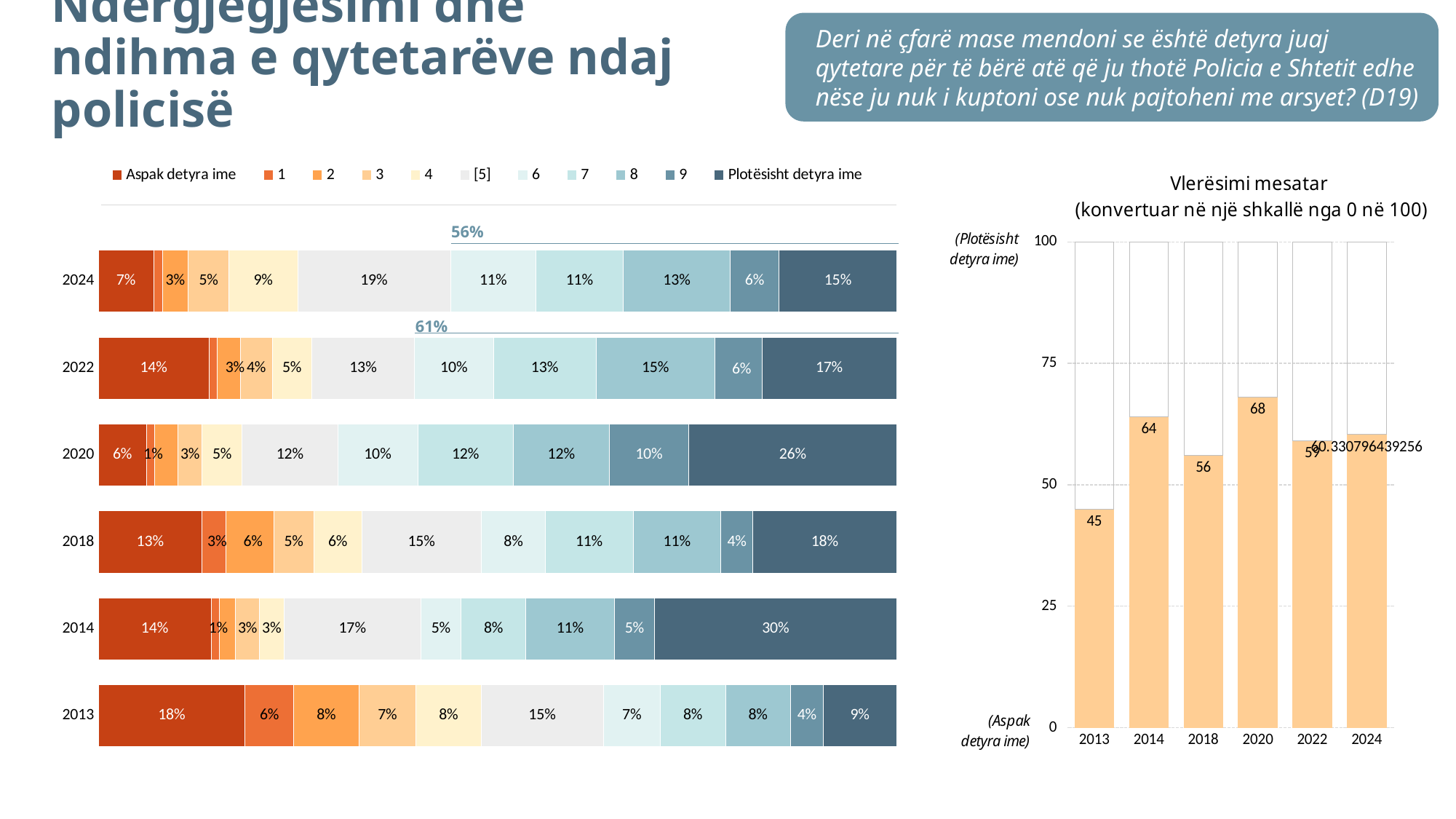
In the stacked bar chart on the left, what is the value of the '[5]' segment for 2024? 19% In the 'Vlerësimi mesatar' chart on the right, what is the value for 2020? 68 In the stacked bar chart on the left, how many years are shown? 6 In the 'Vlerësimi mesatar' chart on the right, what is the difference between the values for 2020 and 2013? 23 In the stacked bar chart on the left, what percentage of respondents in 2013 answered 'Aspak detyra ime'? 18% In the stacked bar chart on the left, what percentage of respondents in 2014 answered 'Plotësisht detyra ime'? 30% In the 'Vlerësimi mesatar' chart on the right, what is the value for 2013? 45 In the stacked bar chart on the left, which is larger: the 'Aspak detyra ime' share in 2013 or in 2024? 2013 What kind of chart is the 'Vlerësimi mesatar' chart on the right? Bar chart In the stacked bar chart on the left, which year has the largest 'Plotësisht detyra ime' segment? 2014 In the stacked bar chart on the left, how many series does the legend list? 11 In the 'Vlerësimi mesatar' chart on the right, which year has the highest value? 2020